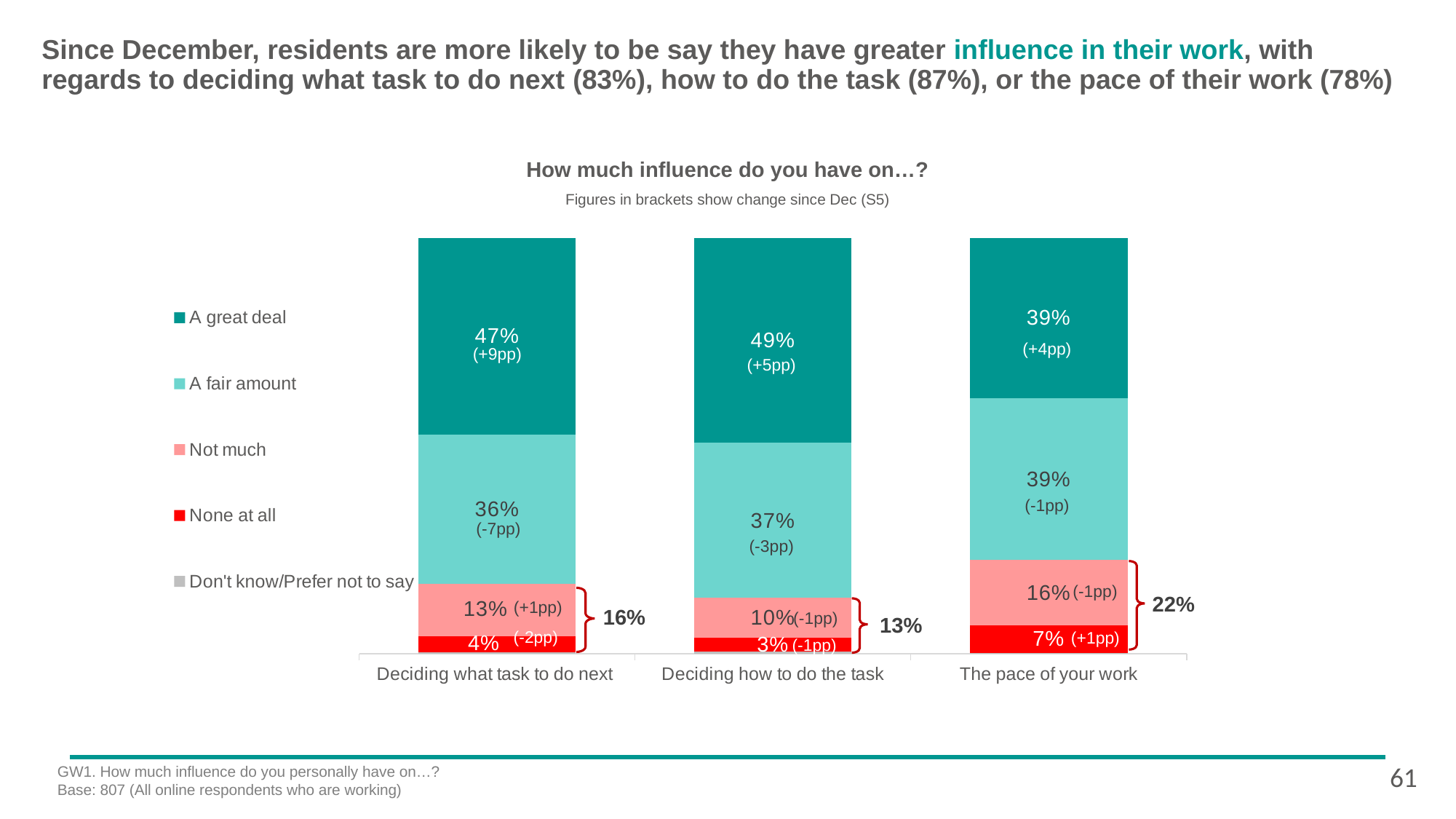
What percentage say they have 'None at all' influence on the pace of their work? 7% What percentage of respondents say they have 'A great deal' of influence on deciding what task to do next? 47% What is the change since December shown for 'A great deal' on deciding what task to do next? +9pp Which category has the highest 'A great deal' value? Deciding how to do the task How many series does the legend list? 5 What kind of chart is shown on the slide? Stacked bar chart Is the 'Not much' value larger for the pace of your work or for deciding what task to do next? The pace of your work What is the difference between the 'A great deal' values for deciding how to do the task and the pace of your work? 10% What is the combined 'Not much' and 'None at all' share shown for the pace of your work? 22% Which category has the lowest 'None at all' value? Deciding how to do the task What percentage say they have 'A fair amount' of influence on deciding how to do the task? 37% How many categories are shown on the x axis? 3